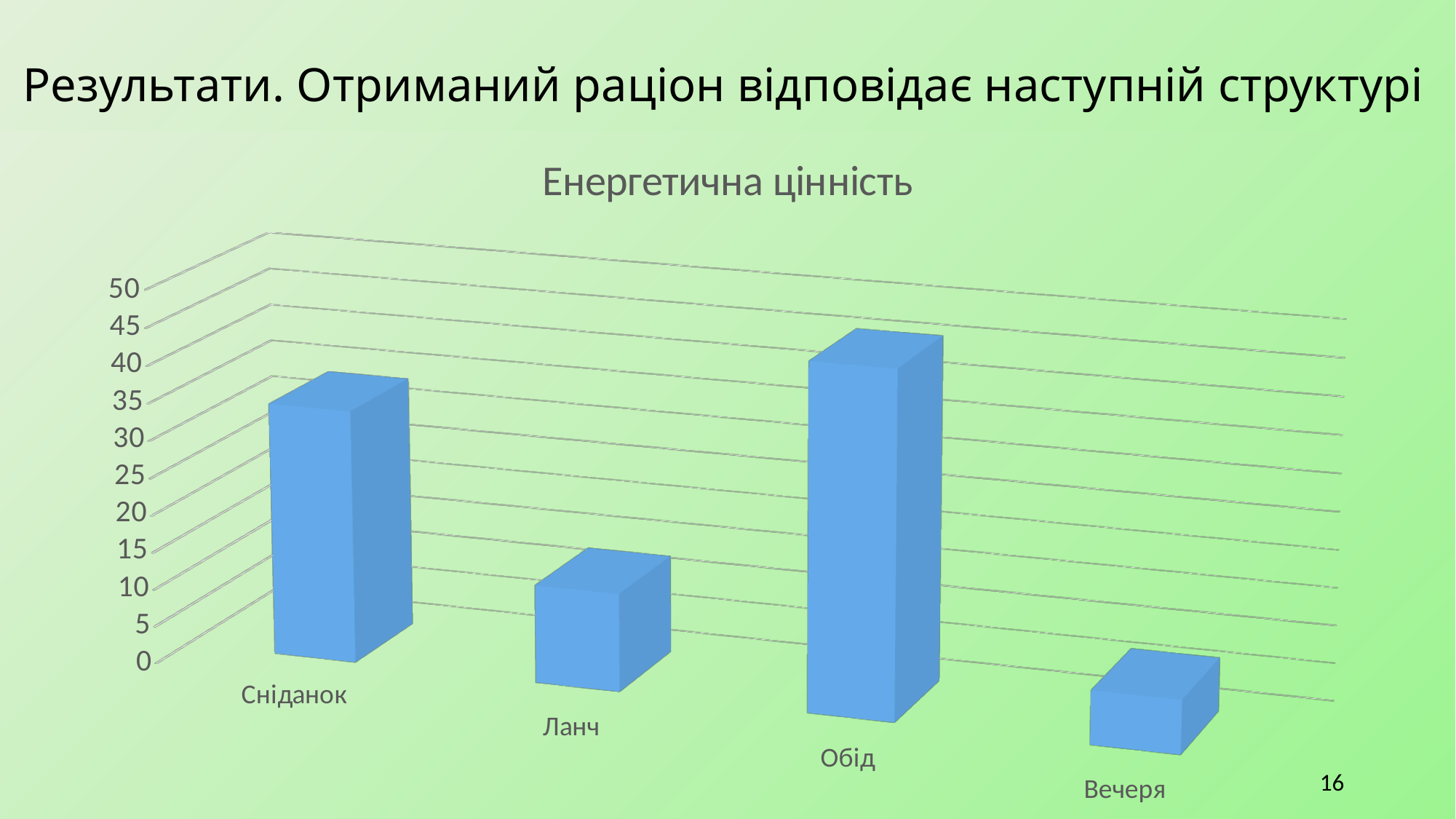
Is the value for Обід greater or less than 30? greater Which is larger, the value for Обід or the value for Вечеря? Обід Is the value for Сніданок greater or less than 20? greater What colour are the bars in the chart? blue Which category has the highest value in the chart? Обід Which category has the lowest value in the chart? Вечеря What is the title of the chart? Енергетична цінність Is the value for Вечеря greater or less than 15? less How many categories are shown on the x axis of the chart? 4 What kind of chart is shown on the slide? bar chart Which is larger, the value for Сніданок or the value for Ланч? Сніданок